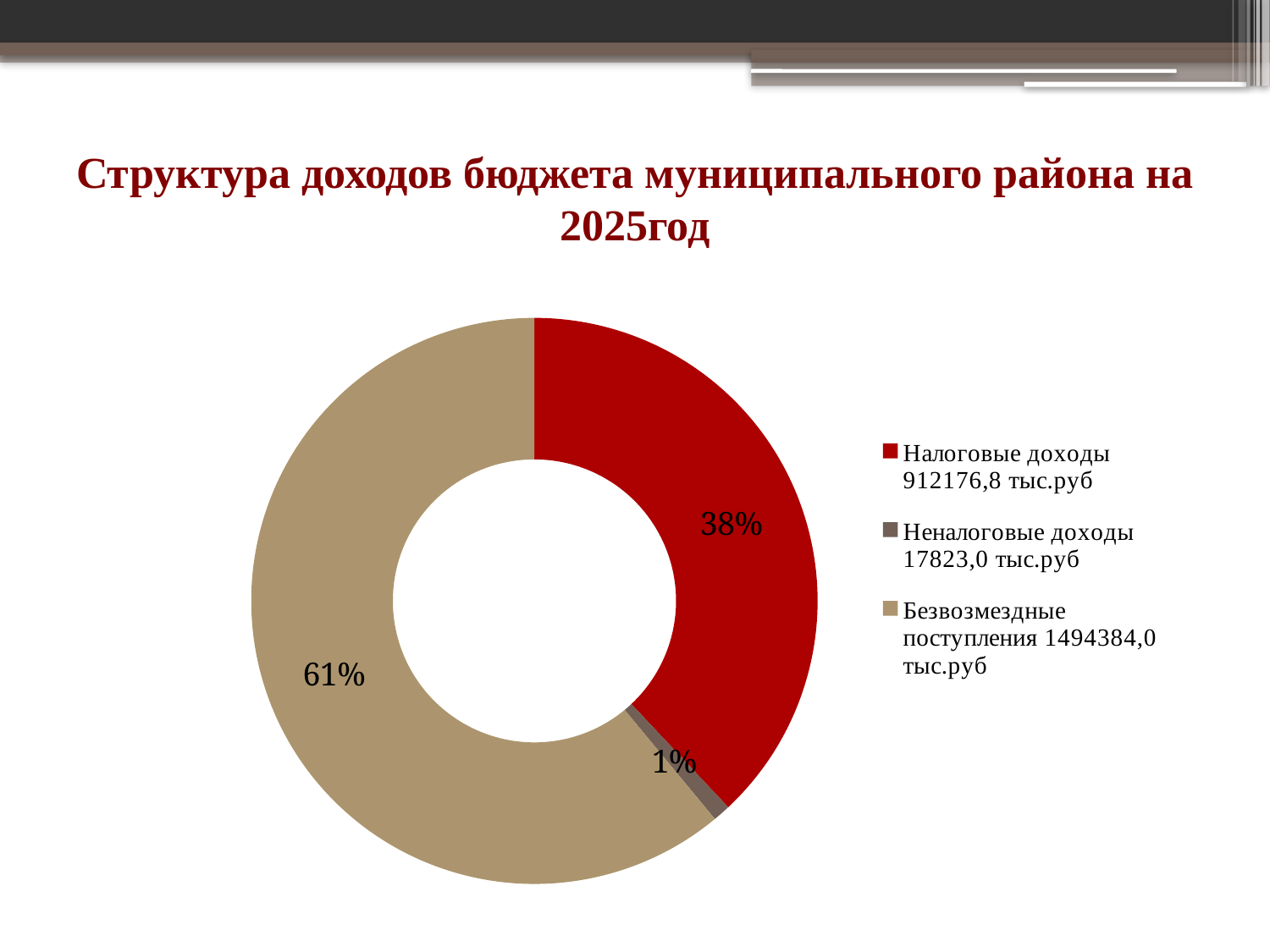
Which is larger: the share for Налоговые доходы or the share for Безвозмездные поступления? Безвозмездные поступления Which category has the smallest share of the pie? Неналоговые доходы What share of the pie does Безвозмездные поступления represent? 61% Which category has the largest share of the pie? Безвозмездные поступления What share of the pie does Неналоговые доходы represent? 1% How many categories are shown in the chart? 3 What amount in тыс.руб does the legend give for Налоговые доходы? 912176,8 тыс.руб What share of the pie does Налоговые доходы represent? 38% What amount in тыс.руб does the legend give for Неналоговые доходы? 17823,0 тыс.руб What kind of chart is shown on the slide? Pie chart (doughnut) What colour is the slice for Налоговые доходы? Red What is the difference in percentage points between the share for Безвозмездные поступления and the share for Налоговые доходы? 23